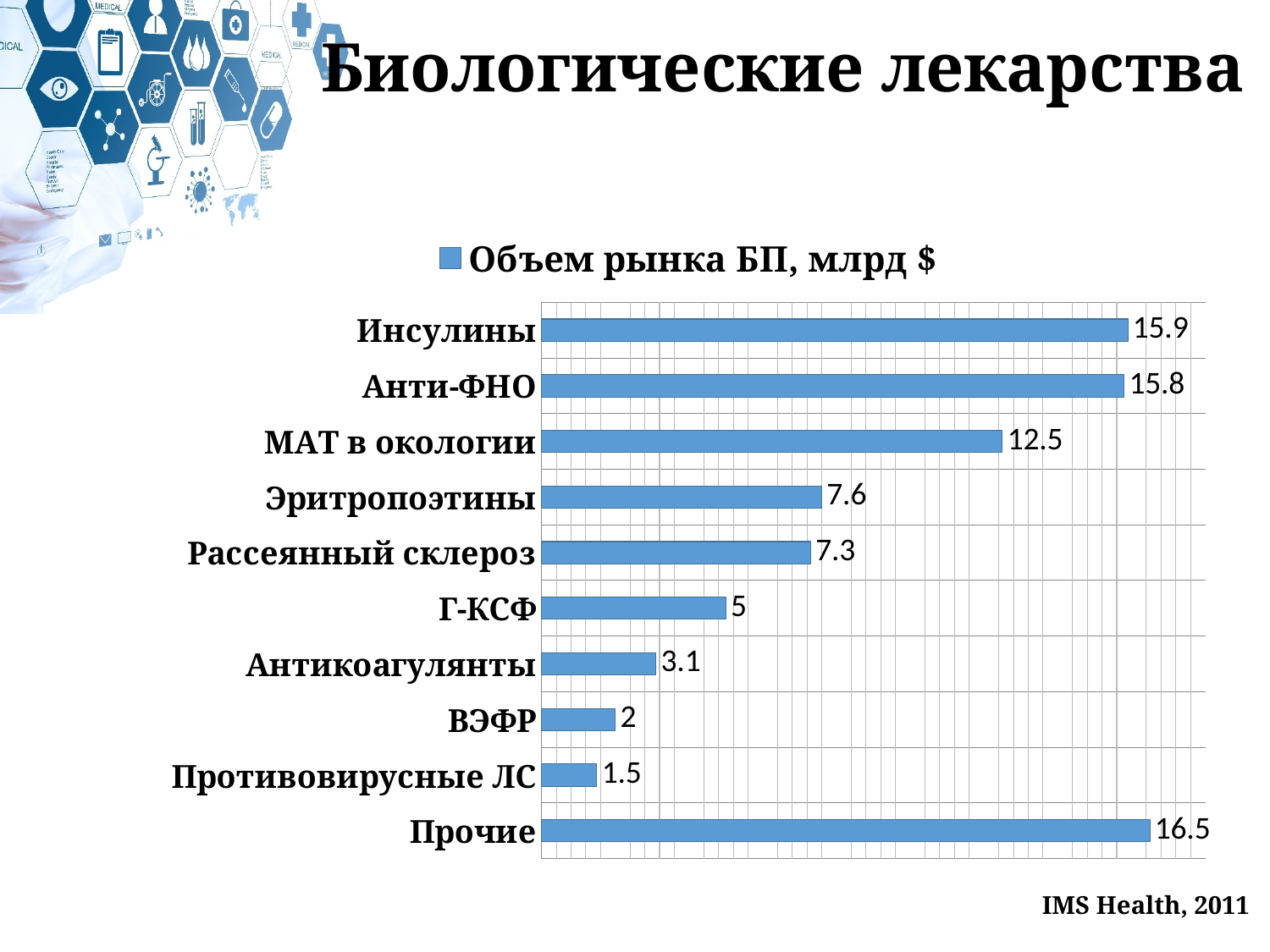
What is the value for Противовирусные ЛС? 1.5 What is the value for Инсулины? 15.9 Which is larger, the value for Г-КСФ or the value for Антикоагулянты? Г-КСФ What is the difference between the values for Эритропоэтины and Рассеянный склероз? 0.3 What kind of chart is shown on the slide? bar chart How many series does the legend list? 1 What is the legend entry of the chart? Объем рынка БП, млрд $ What is the difference between the values for Инсулины and Анти-ФНО? 0.1 How many categories are shown in the chart? 10 Which category has the highest value? Прочие Which category has the lowest value? Противовирусные ЛС